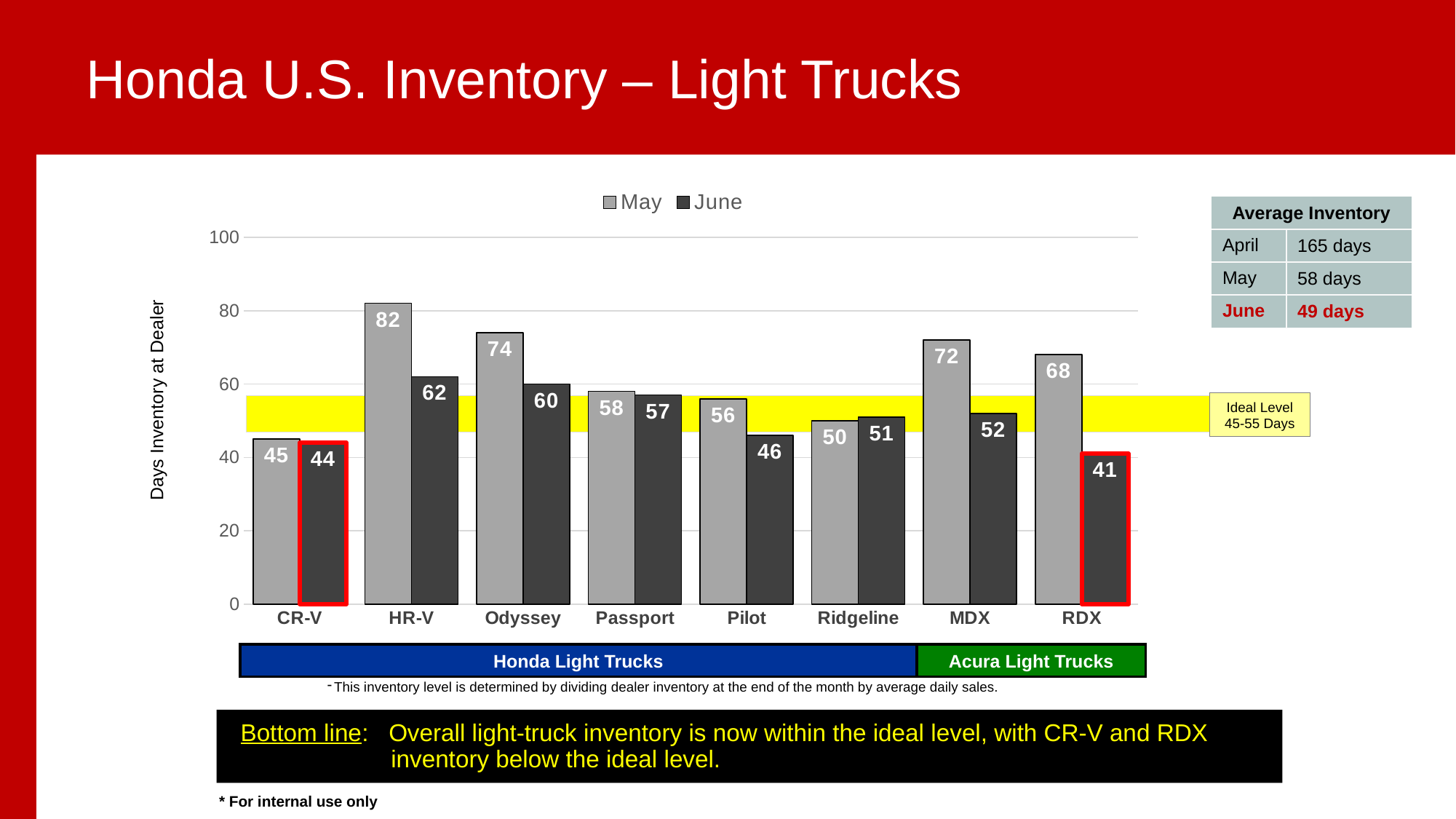
How many series does the chart legend list? 2 What is the May days inventory value for MDX? 72 What is the June days inventory value for RDX? 41 What is the difference between the May and June values for HR-V? 20 What is the difference between the May and June values for Pilot? 10 What kind of chart is shown on the slide? Bar chart What is the label of the y axis of the chart? Days Inventory at Dealer What is the June days inventory value for HR-V? 62 How many models are shown on the x axis of the chart? 8 Which is larger for Ridgeline, the May value or the June value? June Which model has the highest May days inventory? HR-V Which model has the lowest June days inventory? RDX